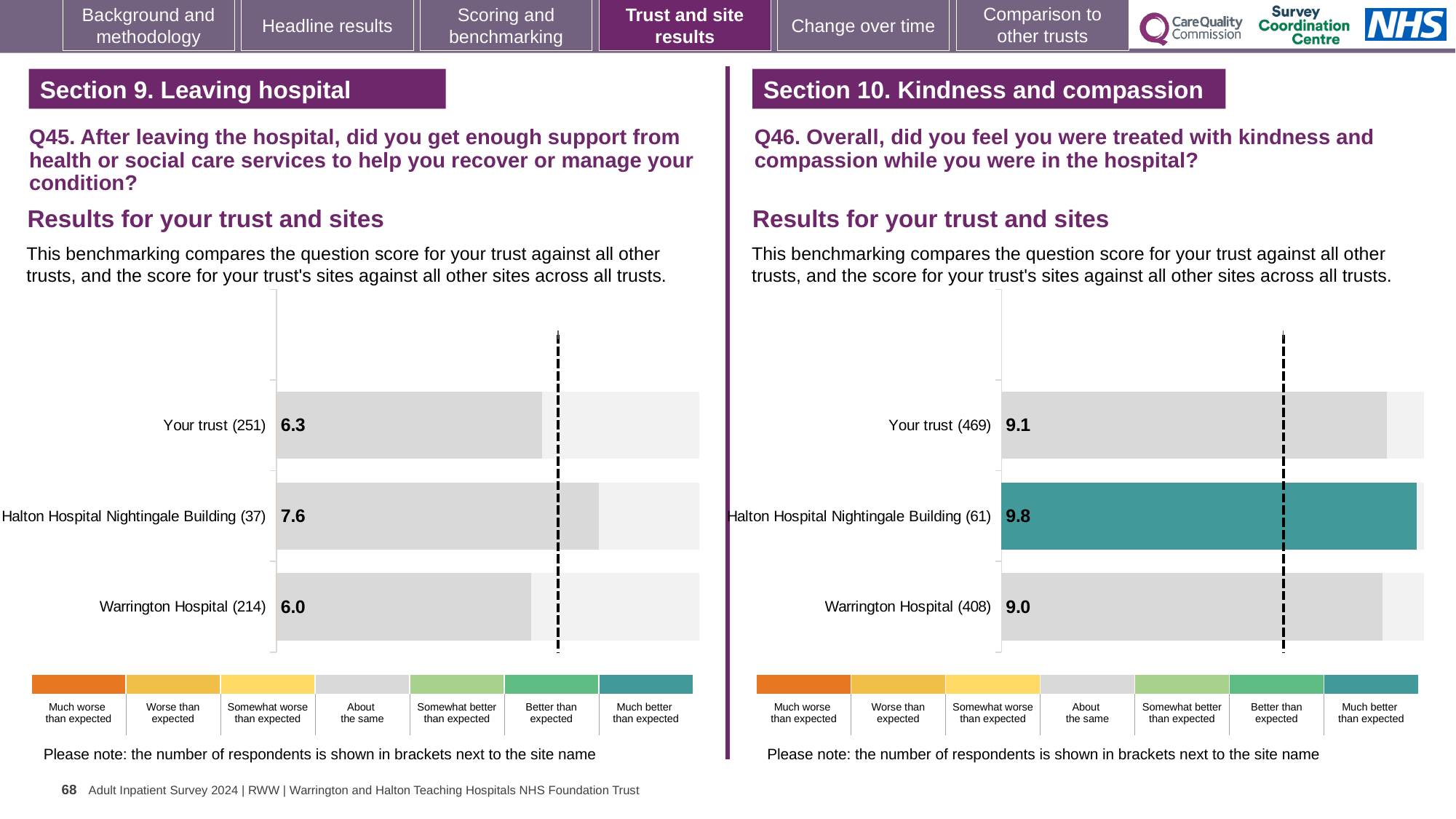
On the Q45 chart (left), which site or trust has the lowest score? Warrington Hospital On the Q46 chart (right), what is the difference between the scores for Halton Hospital Nightingale Building and Your trust? 0.7 On the Q46 chart (right), which site or trust has the highest score? Halton Hospital Nightingale Building On the Q46 chart (right), which has the larger score, Your trust or Warrington Hospital? Your trust On the Q46 chart (right), which benchmark category does the colour of the Halton Hospital Nightingale Building bar correspond to? Much better than expected On the Q45 chart (left), what is the score for Halton Hospital Nightingale Building? 7.6 On the Q45 chart (left), how many respondents are shown for Warrington Hospital? 214 On the Q46 chart (right), what is the score for Warrington Hospital? 9.0 How many bars are plotted on the Q46 chart (right)? 3 On the Q45 chart (left), what is the score for Your trust? 6.3 What kind of chart is used on the Q45 chart (left)? Bar chart On the Q45 chart (left), what is the difference between the scores for Halton Hospital Nightingale Building and Warrington Hospital? 1.6